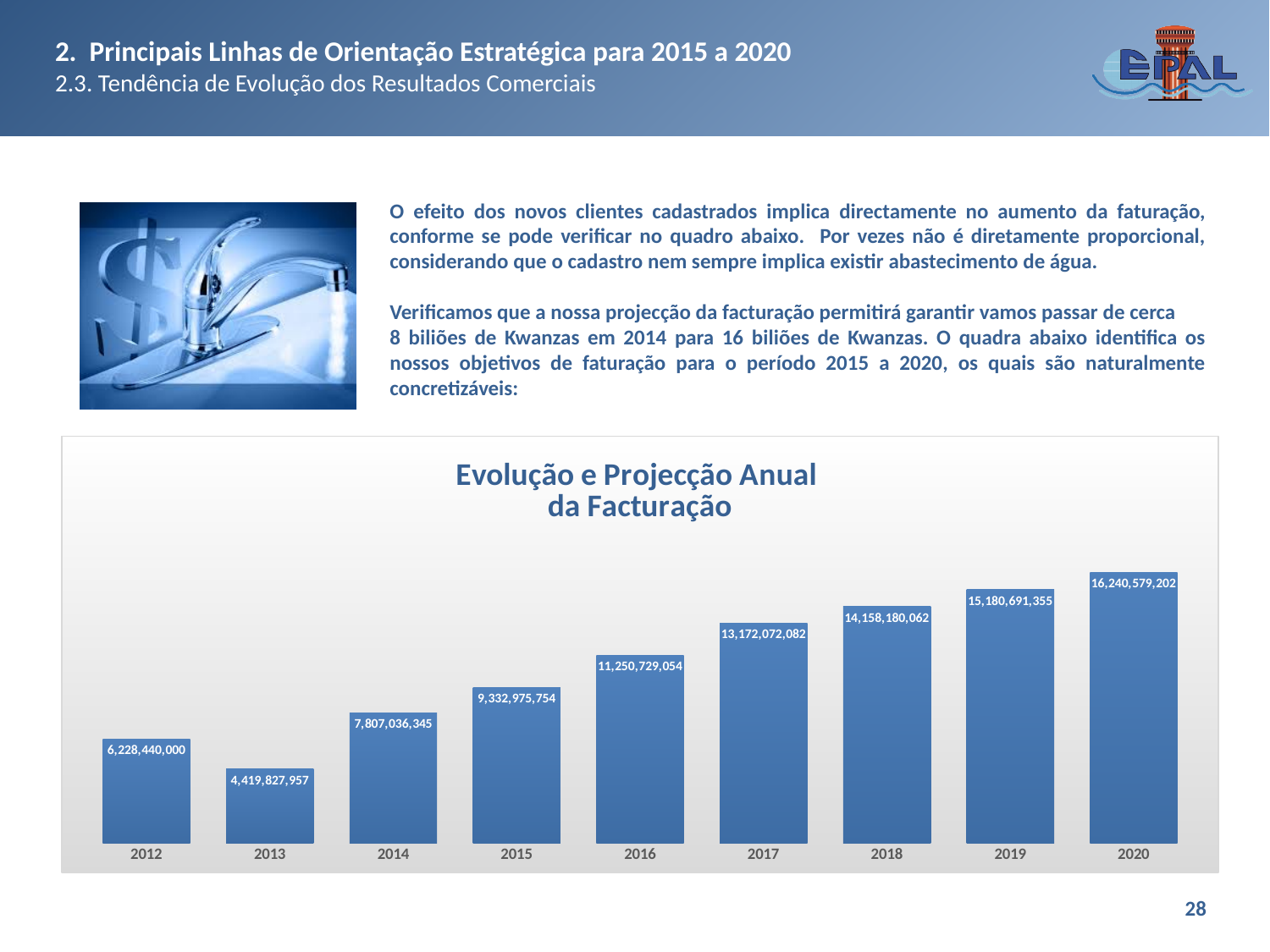
What is the value shown for 2020? 16,240,579,202 Which year has the highest value in the chart? 2020 Which year has the lowest value in the chart? 2013 Which year has the larger value, 2012 or 2013? 2012 How many years are shown on the x axis of the chart? 9 What is the difference between the values for 2020 and 2019? 1,059,887,847 What is the title of the chart on the slide? Evolução e Projecção Anual da Facturação What kind of chart is shown on the slide? Bar chart What is the value shown for 2016? 11,250,729,054 Do the values rise or fall from 2014 to 2020? Rise What is the value shown for 2012? 6,228,440,000 What is the value shown for 2018? 14,158,180,062